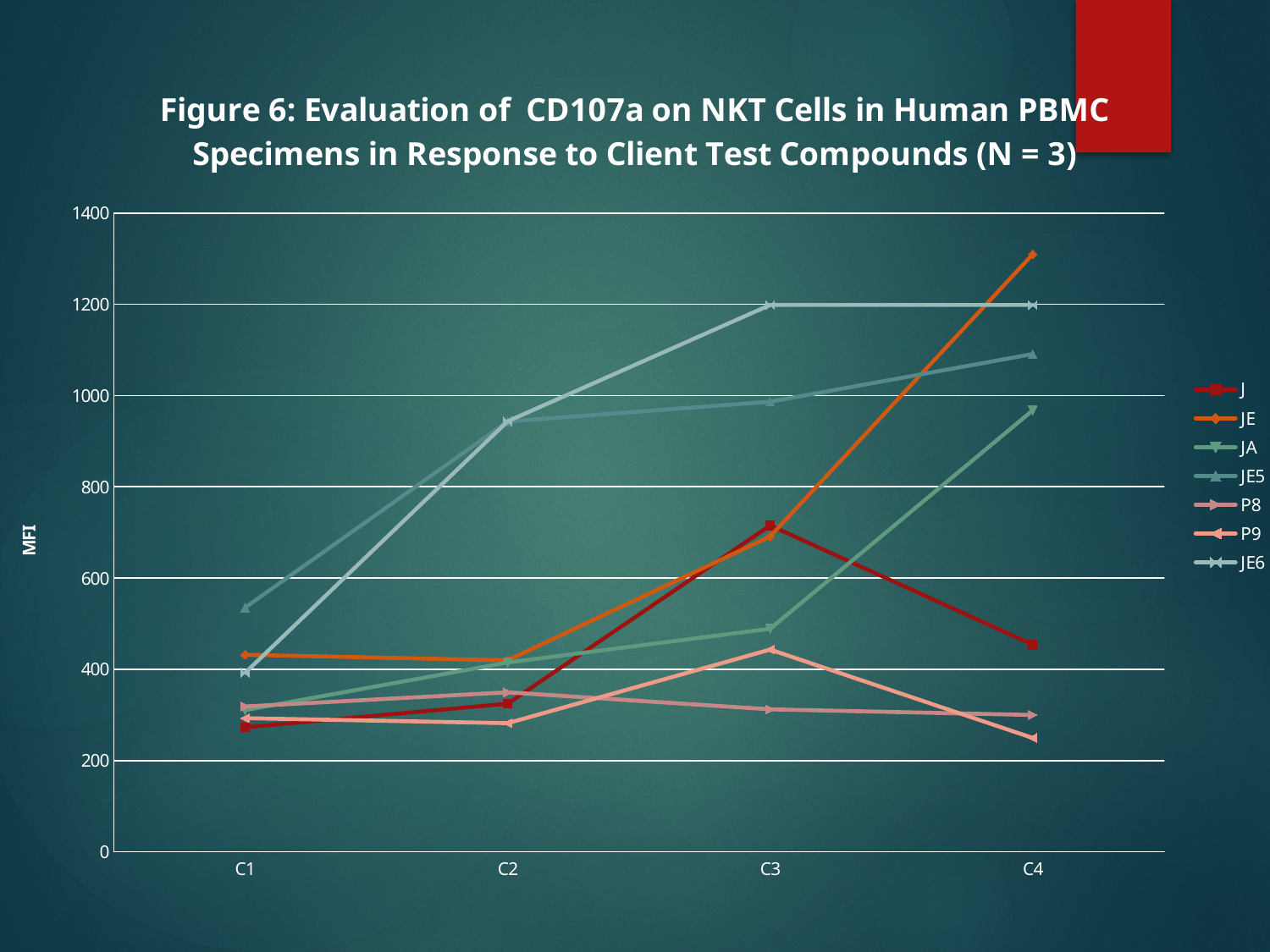
What kind of chart is shown on the slide? line chart Do the values for JE5 rise or fall from C1 to C4? rise Which series has the lowest value at C4? P9 What is the label on the y axis? MFI How many categories are shown on the x axis? 4 Which series has the highest value at C4? JE Is the value for JA at C4 greater or less than 800? greater Is the value for JE at C4 greater or less than 1200? greater Is the value for JE5 at C1 greater or less than 600? less At C3, which series has the larger value, JE6 or J? JE6 How many series does the legend list? 7 For series J, is the value larger at C3 or at C4? C3